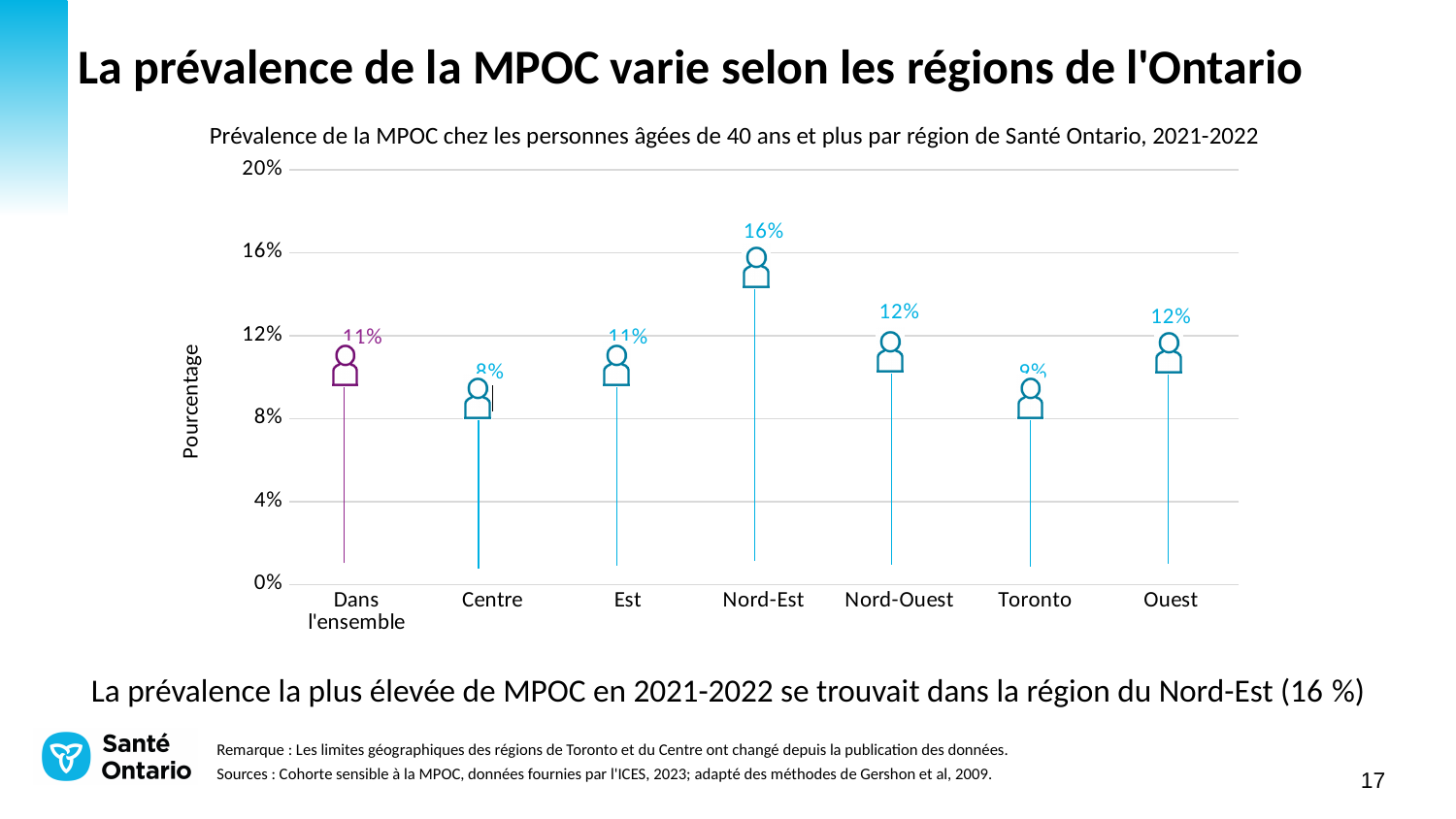
What is the COPD prevalence value shown for Nord-Est? 16% How many categories are shown on the x axis? 7 What value is shown for Ouest? 12% Which is larger, the value for Nord-Est or the value for Nord-Ouest? Nord-Est What is the difference between the Nord-Est value and the Dans l'ensemble value? 5 percentage points What value is shown for Nord-Ouest? 12% What value is shown for Dans l'ensemble? 11% What is the label on the y axis? Pourcentage What is the difference between the Nord-Est value and the Ouest value? 4 percentage points Is the value for Centre greater or less than 12%? less Is the value for Toronto greater or less than 12%? less Which region has the highest prevalence? Nord-Est